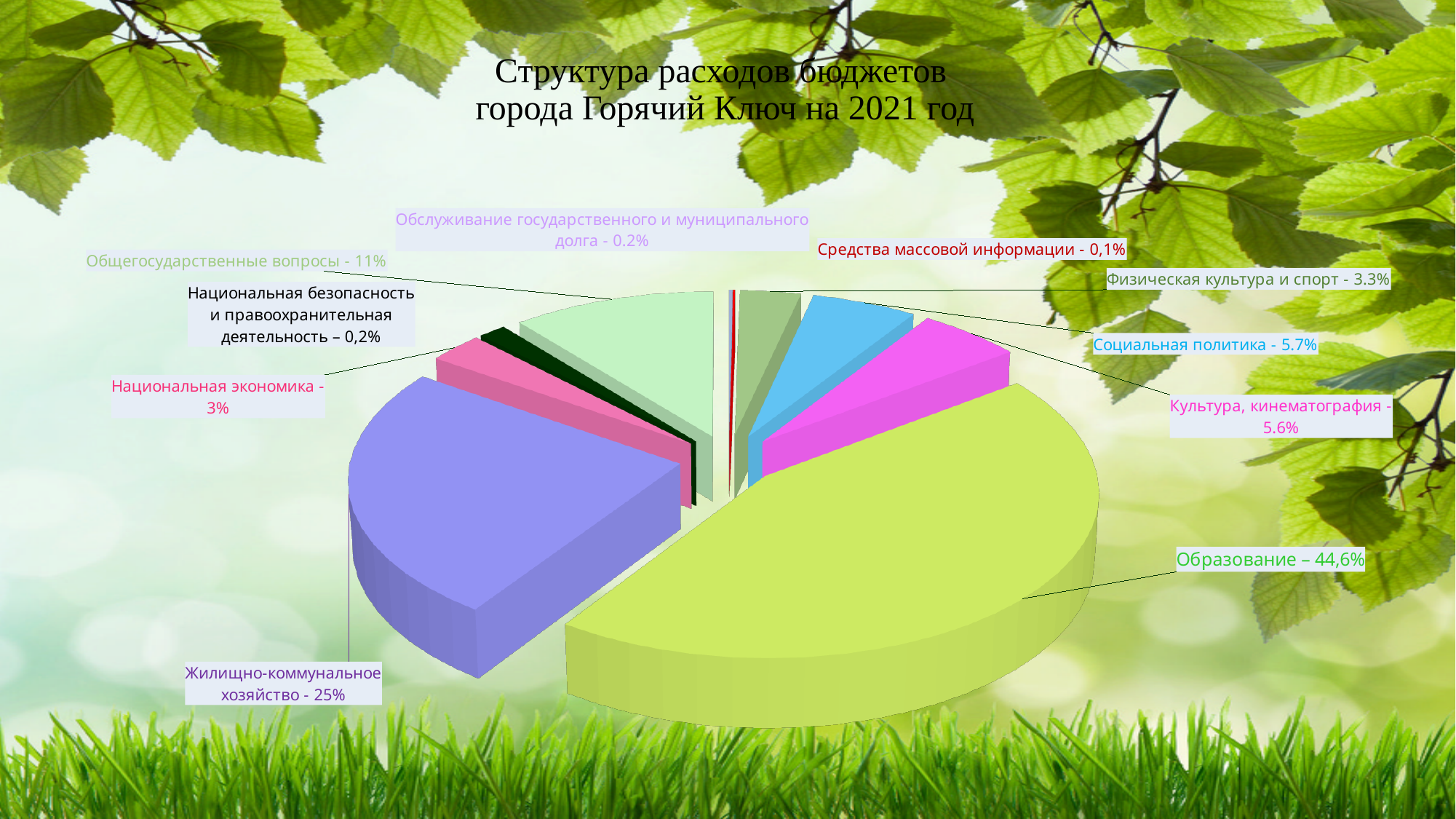
Which category has the largest share of the pie? Образование What is the value shown for Социальная политика? 5.7% What is the difference between the shares of Образование and Жилищно-коммунальное хозяйство? 19,6% How many categories are shown in the pie chart? 10 What is the value shown for Жилищно-коммунальное хозяйство? 25% What is the value shown for Национальная безопасность и правоохранительная деятельность? 0,2% What is the difference between the shares of Общегосударственные вопросы and Национальная экономика? 8% What is the share of Образование in the pie chart? 44,6% Which is larger: the share of Жилищно-коммунальное хозяйство or Общегосударственные вопросы? Жилищно-коммунальное хозяйство What kind of chart is shown on the slide? Pie chart Which category has the smallest share of the pie? Средства массовой информации What is the title of the chart on the slide? Структура расходов бюджетов города Горячий Ключ на 2021 год